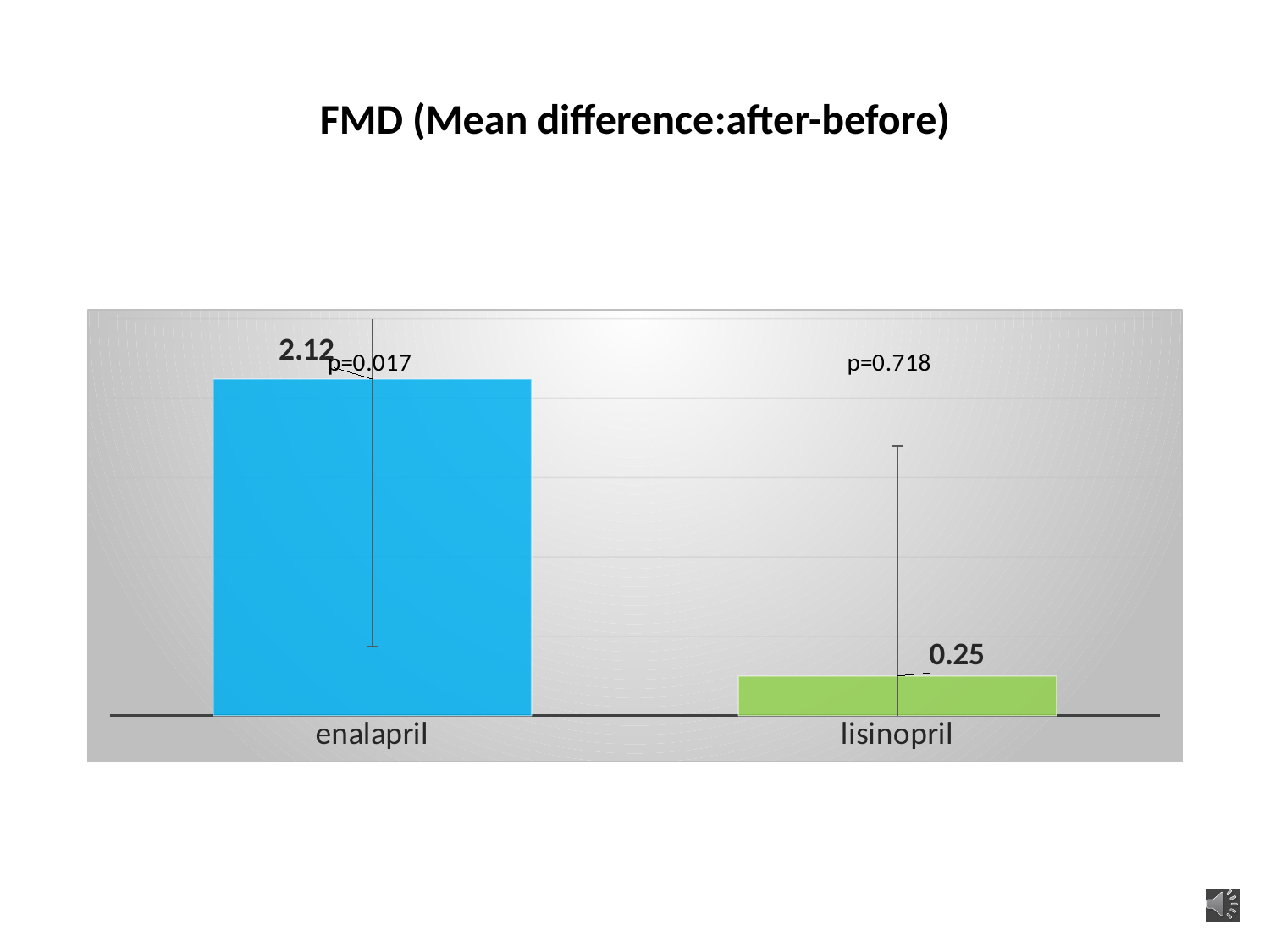
Which category has the lowest value? lisinopril What is the value for lisinopril? 0.25 What kind of chart is shown on the slide? bar chart Which is larger, the value for enalapril or the value for lisinopril? enalapril Which category has the highest value? enalapril What is the title of the chart? FMD (Mean difference:after-before) Do the values rise or fall from enalapril to lisinopril? fall What is the value for enalapril? 2.12 How many categories are shown on the chart? 2 What p-value is shown for enalapril? p=0.017 What is the difference between the values for enalapril and lisinopril? 1.87